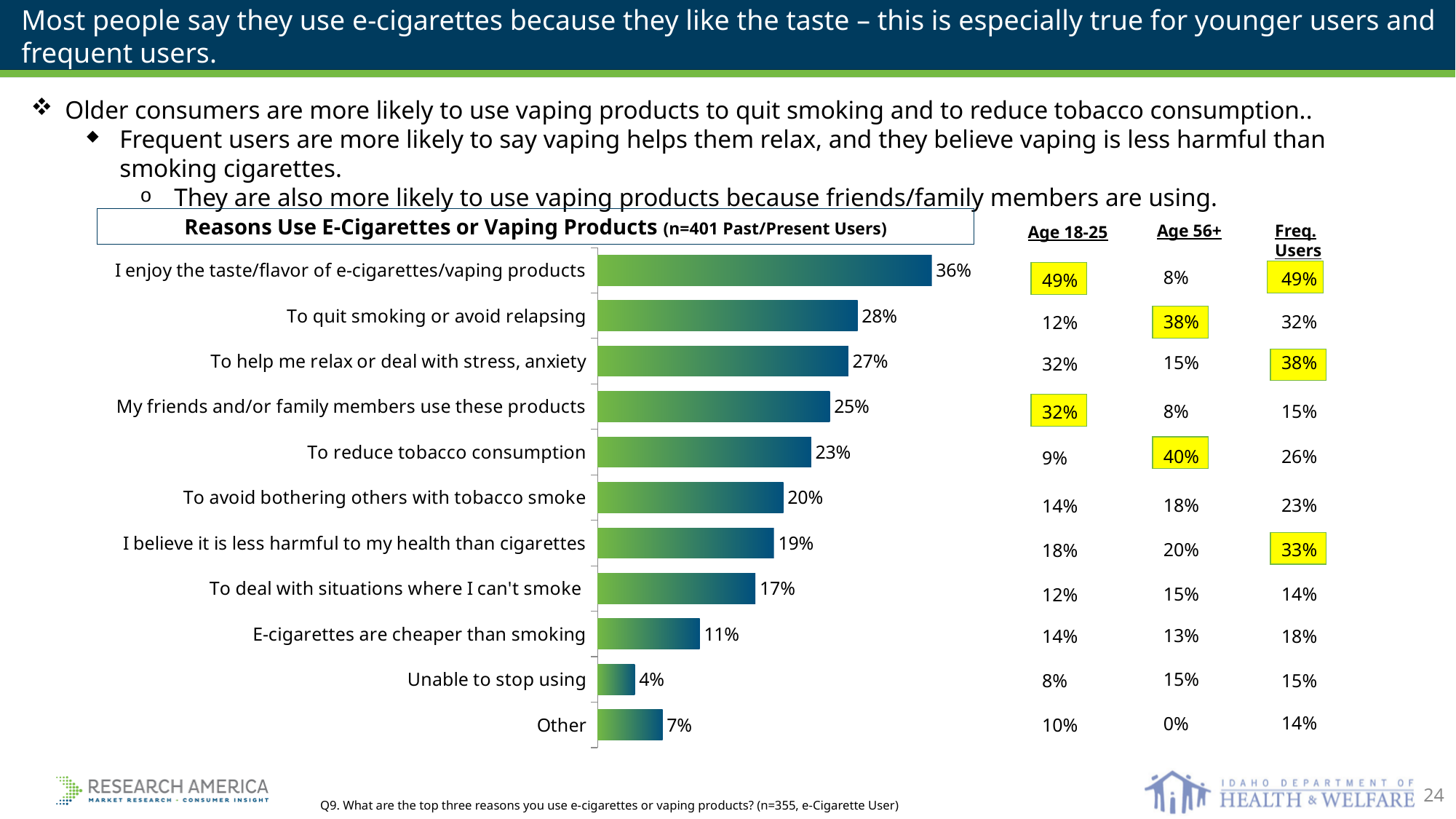
Which reason has the highest percentage in the chart? I enjoy the taste/flavor of e-cigarettes/vaping products How many reasons (categories) are plotted in the bar chart? 11 What is the value shown for "To quit smoking or avoid relapsing"? 28% What is the difference between the percentage for "I enjoy the taste/flavor of e-cigarettes/vaping products" and "To quit smoking or avoid relapsing"? 8 percentage points Which has a lower percentage: "Unable to stop using" or "Other"? Unable to stop using What type of chart is used to show the reasons for using e-cigarettes or vaping products? Bar chart What is the value for the "Other" category? 7% What is the title of the chart? Reasons Use E-Cigarettes or Vaping Products Which reason has the lowest percentage in the chart? Unable to stop using What percentage of users say they use e-cigarettes because they enjoy the taste/flavor? 36% What percentage is shown for "E-cigarettes are cheaper than smoking"? 11% Which has a higher percentage: "To reduce tobacco consumption" or "To avoid bothering others with tobacco smoke"? To reduce tobacco consumption